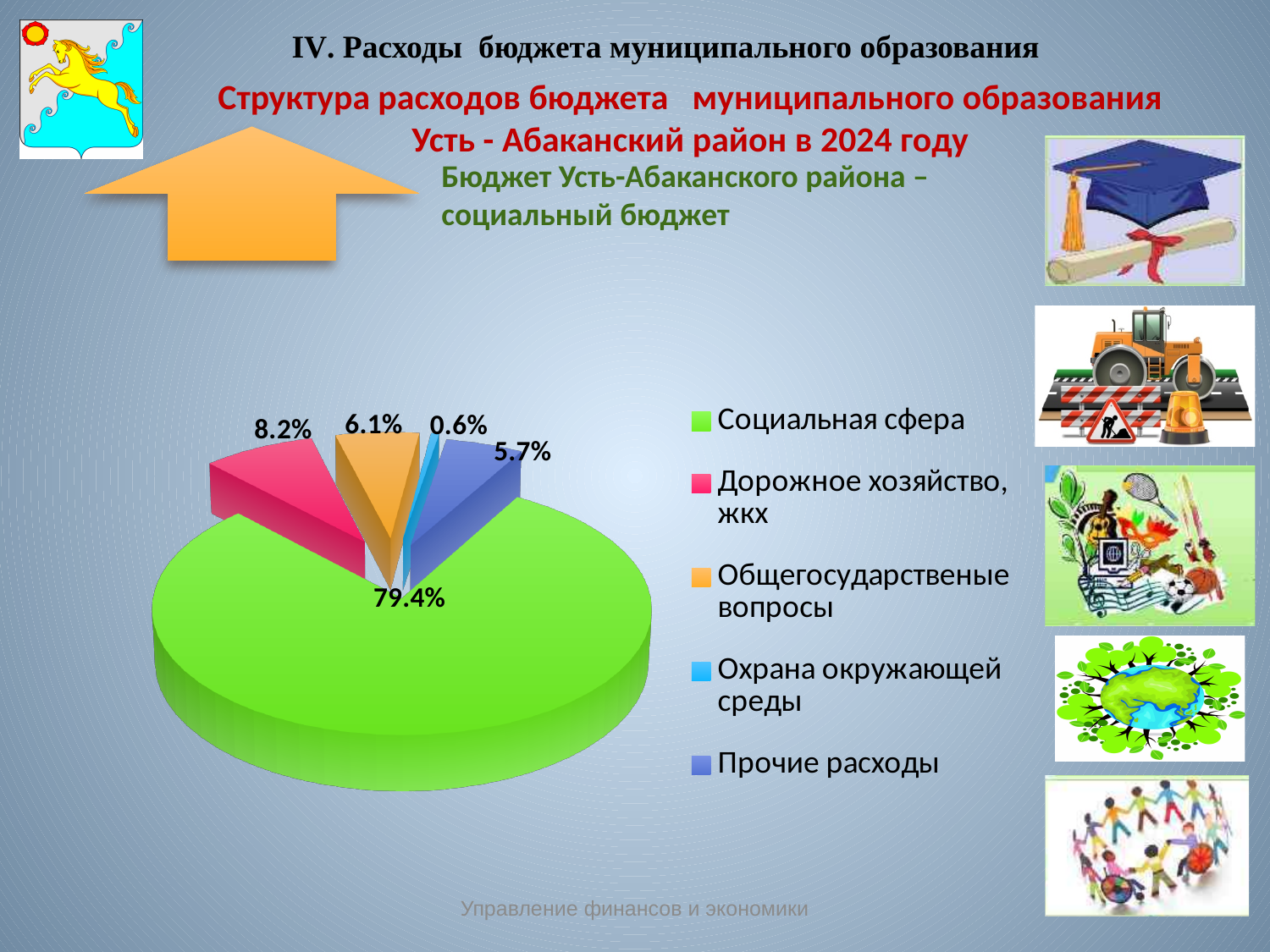
What colour is the slice for Социальная сфера? Green What is the value for Охрана окружающей среды in the pie chart? 0.6% What share is labelled for Прочие расходы? 5.7% What type of chart is shown on the slide? Pie chart Which category has the smallest slice of the pie chart? Охрана окружающей среды What share of the pie chart does Социальная сфера account for? 79.4% What is the value shown for Дорожное хозяйство, жкх in the pie chart? 8.2% How many categories does the pie chart show? 5 What is the difference between the shares of Дорожное хозяйство, жкх and Прочие расходы? 2.5% What percentage is shown for Общегосударственые вопросы? 6.1% Which is larger: the share of Общегосударственые вопросы or the share of Прочие расходы? Общегосударственые вопросы Which category has the largest slice of the pie chart? Социальная сфера